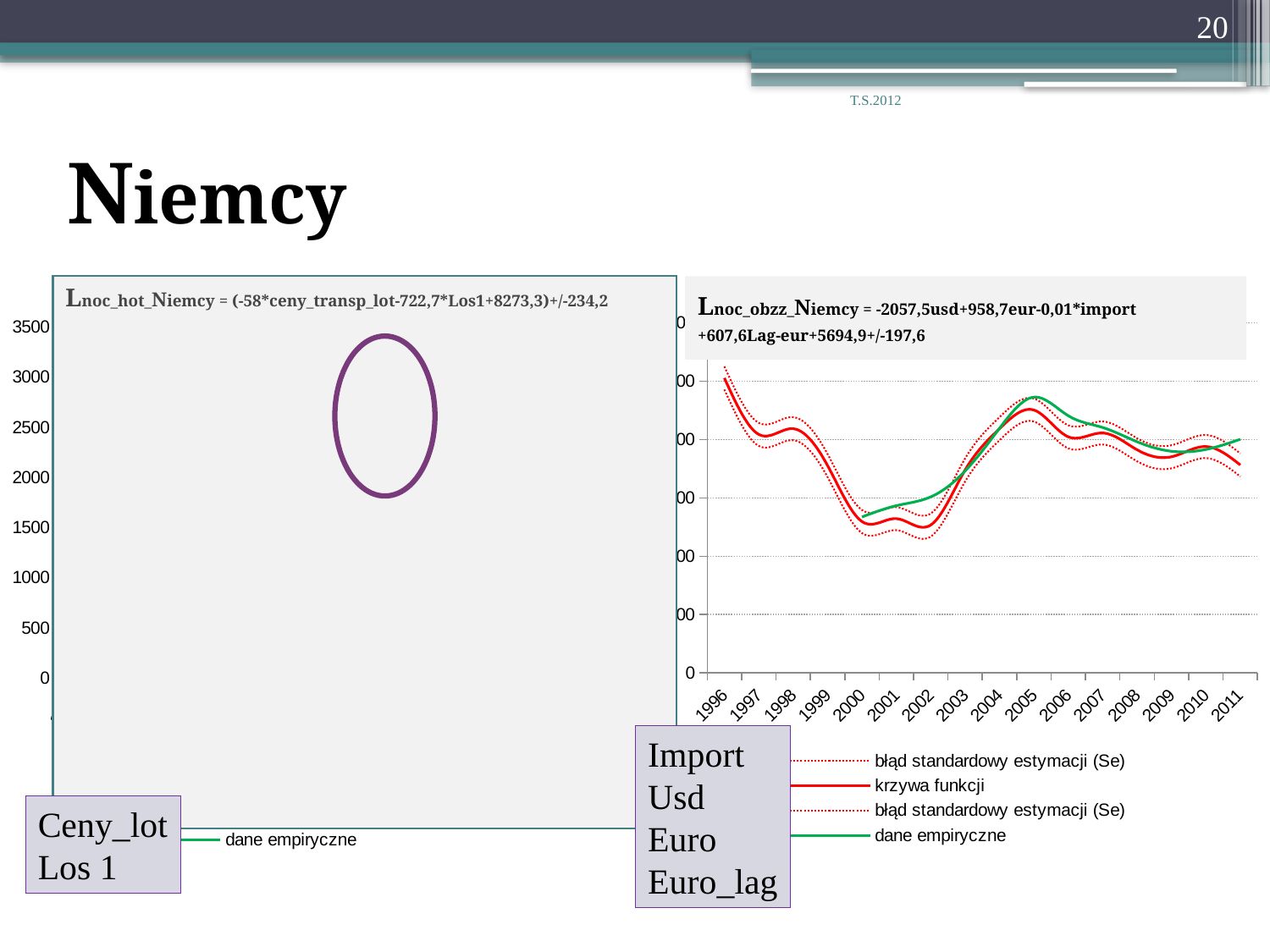
In the right-hand chart, is the red 'krzywa funkcji' line higher in 1996 or in 2001? 1996 What is the first year labelled on the x axis of the right-hand chart? 1996 How many series does the legend of the right-hand chart list? 4 What is the last year labelled on the x axis of the right-hand chart? 2011 What kind of chart is the chart on the right of the slide (Lnoc_obzz_Niemcy)? line chart In the right-hand chart, does the green 'dane empiryczne' line rise or fall between 2002 and 2005? rise How many series does the legend of the left-hand chart (Lnoc_hot_Niemcy) list? 1 What is the highest tick value shown on the y axis of the left-hand chart (Lnoc_hot_Niemcy)? 3500 In the right-hand chart, does the red 'krzywa funkcji' line rise or fall between 1996 and 2000? fall In the right-hand chart, in which year does the green 'dane empiryczne' line reach its highest point? 2005 How many years are labelled on the x axis of the right-hand chart? 16 In the right-hand chart, is the green 'dane empiryczne' line higher in 2005 or in 2009? 2005